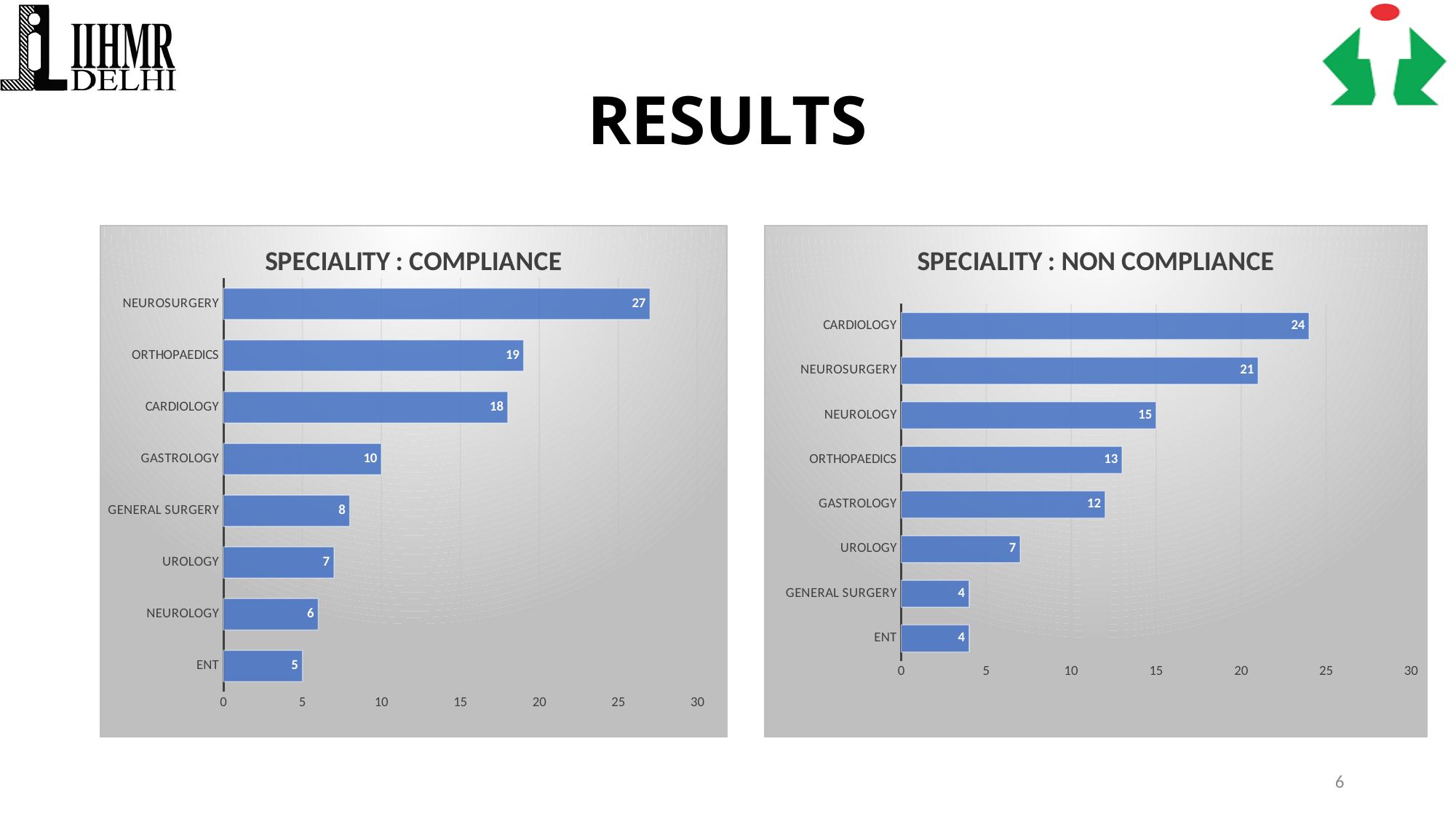
How many specialities are shown in the SPECIALITY : COMPLIANCE chart? 8 In the SPECIALITY : NON COMPLIANCE chart, what is the value for GASTROLOGY? 12 In the SPECIALITY : COMPLIANCE chart, which is larger, the value for GASTROLOGY or the value for GENERAL SURGERY? GASTROLOGY In the SPECIALITY : NON COMPLIANCE chart, what is the value for UROLOGY? 7 In the SPECIALITY : NON COMPLIANCE chart, what is the difference between the values for CARDIOLOGY and NEUROSURGERY? 3 In the SPECIALITY : COMPLIANCE chart, what is the value for NEUROSURGERY? 27 In the SPECIALITY : COMPLIANCE chart, which speciality has the lowest value? ENT What kind of chart is the SPECIALITY : NON COMPLIANCE chart? bar chart What is the title of the chart on the left side of the slide? SPECIALITY : COMPLIANCE In the SPECIALITY : NON COMPLIANCE chart, which speciality has the highest value? CARDIOLOGY In the SPECIALITY : NON COMPLIANCE chart, is the value for NEUROLOGY greater or less than 10? greater In the SPECIALITY : COMPLIANCE chart, what is the difference between the values for ORTHOPAEDICS and CARDIOLOGY? 1